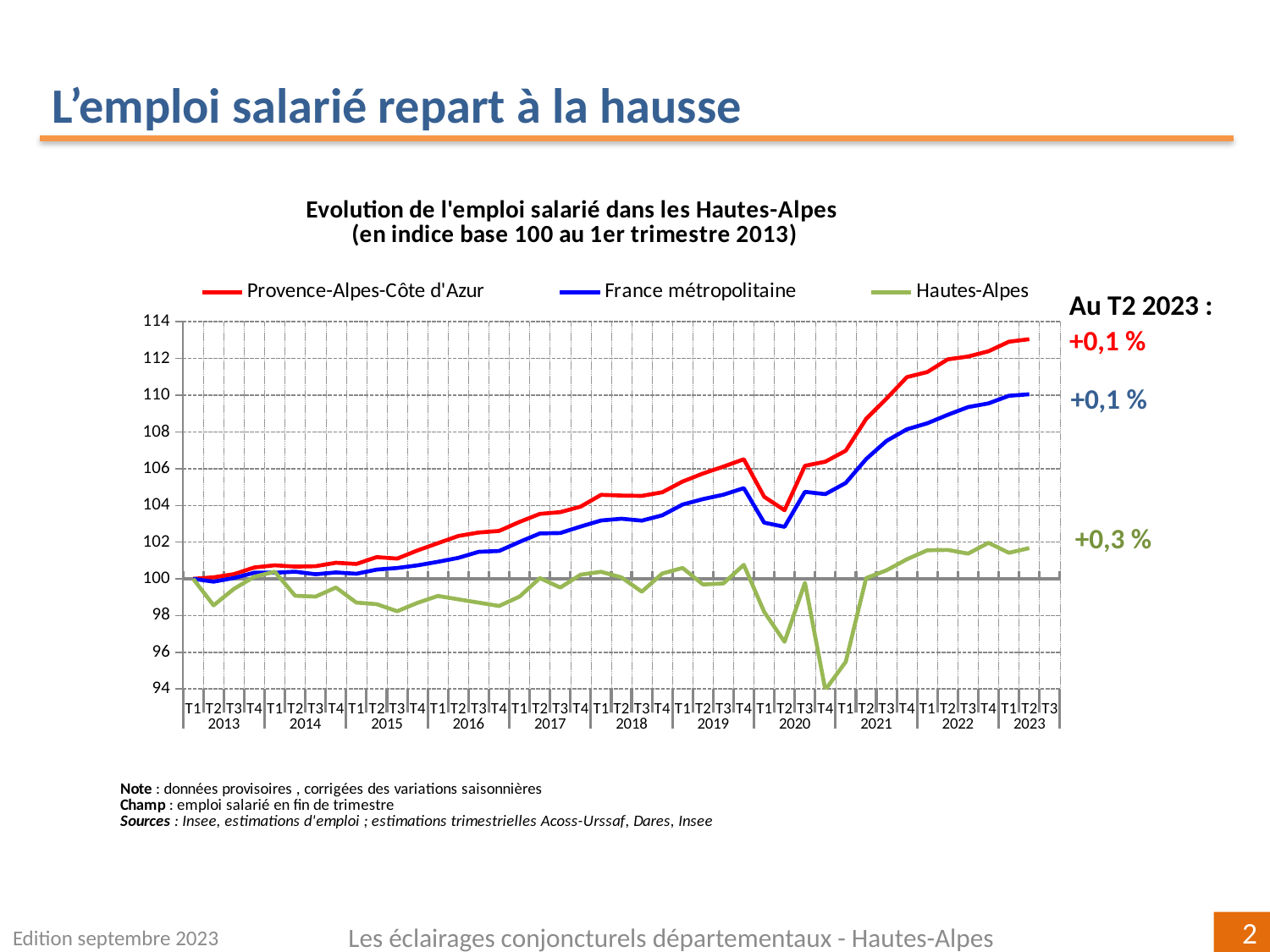
Does the Provence-Alpes-Côte d'Azur series generally rise or fall from 2013 to 2023? rise According to the annotation on the right, what is the change for Provence-Alpes-Côte d'Azur at T2 2023? +0,1 % At T2 2023, which series is higher: Provence-Alpes-Côte d'Azur or France métropolitaine? Provence-Alpes-Côte d'Azur What kind of chart is shown on the slide? line chart Which three series are listed in the legend? Provence-Alpes-Côte d'Azur, France métropolitaine, Hautes-Alpes According to the annotation on the right, what is the change for Hautes-Alpes at T2 2023? +0,3 % Is the value for France métropolitaine at T2 2023 greater or less than 108? greater Is the value for Provence-Alpes-Côte d'Azur at T2 2023 greater or less than 112? greater What is the title of the chart? Evolution de l'emploi salarié dans les Hautes-Alpes (en indice base 100 au 1er trimestre 2013) How many series does the legend list? 3 Which series has the lowest value at T4 2020? Hautes-Alpes Is the value for Hautes-Alpes at T4 2020 greater or less than 96? less